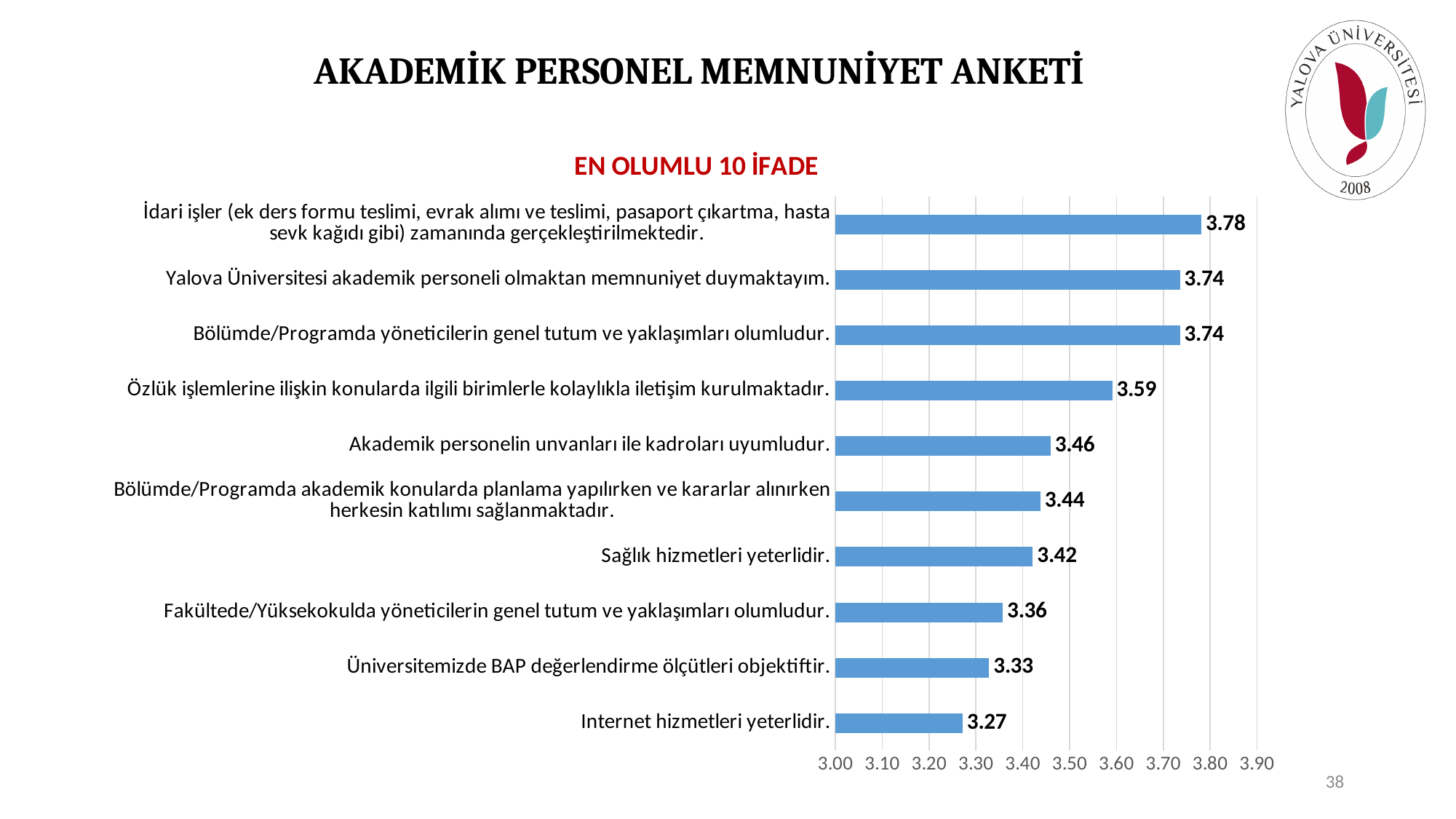
What is the value for "Internet hizmetleri yeterlidir."? 3.27 What kind of chart is shown on the slide? bar chart Which statement has the lowest value? Internet hizmetleri yeterlidir. Which has a larger value: "Sağlık hizmetleri yeterlidir." or "Fakültede/Yüksekokulda yöneticilerin genel tutum ve yaklaşımları olumludur."? Sağlık hizmetleri yeterlidir. What is the value for "Sağlık hizmetleri yeterlidir."? 3.42 Is the value for "Bölümde/Programda yöneticilerin genel tutum ve yaklaşımları olumludur." greater or less than 3.70? greater What is the difference between the values for "Akademik personelin unvanları ile kadroları uyumludur." and "Üniversitemizde BAP değerlendirme ölçütleri objektiftir."? 0.13 What is the value for "Özlük işlemlerine ilişkin konularda ilgili birimlerle kolaylıkla iletişim kurulmaktadır."? 3.59 What is the title of the chart? EN OLUMLU 10 İFADE How many statements are shown in the chart? 10 What is the difference between the highest value (3.78) and the lowest value (3.27)? 0.51 Which statement has the highest value? İdari işler (ek ders formu teslimi, evrak alımı ve teslimi, pasaport çıkartma, hasta sevk kağıdı gibi) zamanında gerçekleştirilmektedir.